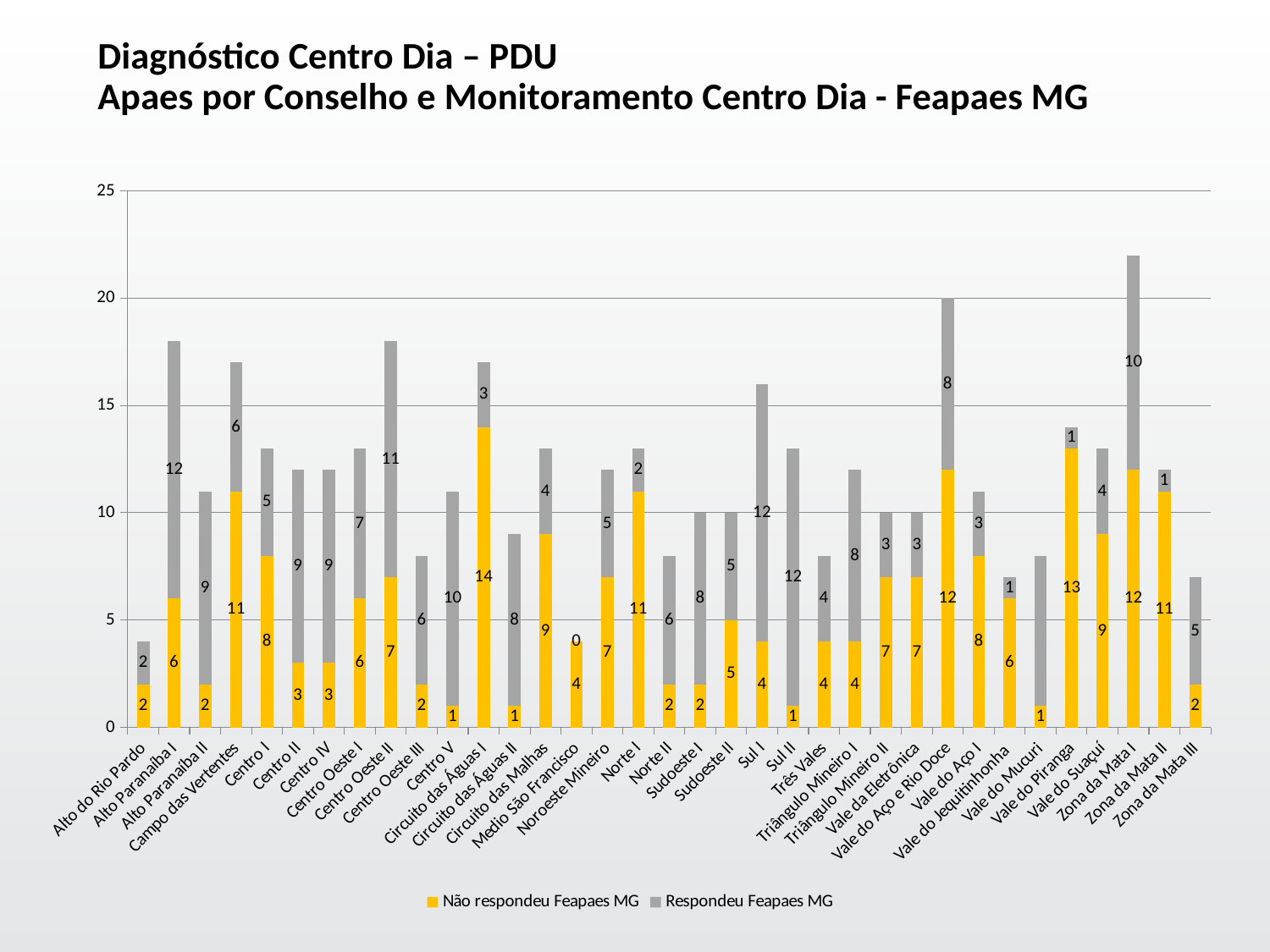
Which category has the tallest stacked bar overall? Zona da Mata I What is the total of the stacked bar for Vale do Aço e Rio Doce? 20 Which category has the highest 'Não respondeu Feapaes MG' value? Circuito das Águas I What kind of chart is shown on the slide? stacked bar chart What is the difference between the 'Respondeu Feapaes MG' values for Sul I and Três Vales? 8 How many series does the legend list? 2 Which series is shown in yellow? Não respondeu Feapaes MG What is the total of the stacked bar for Zona da Mata I? 22 What is the 'Respondeu Feapaes MG' value for Medio São Francisco? 0 What is the 'Não respondeu Feapaes MG' value for Circuito das Águas I? 14 What is the 'Respondeu Feapaes MG' value for Alto Paranaíba I? 12 Which is larger, the 'Não respondeu Feapaes MG' value for Vale do Piranga or for Centro I? Vale do Piranga